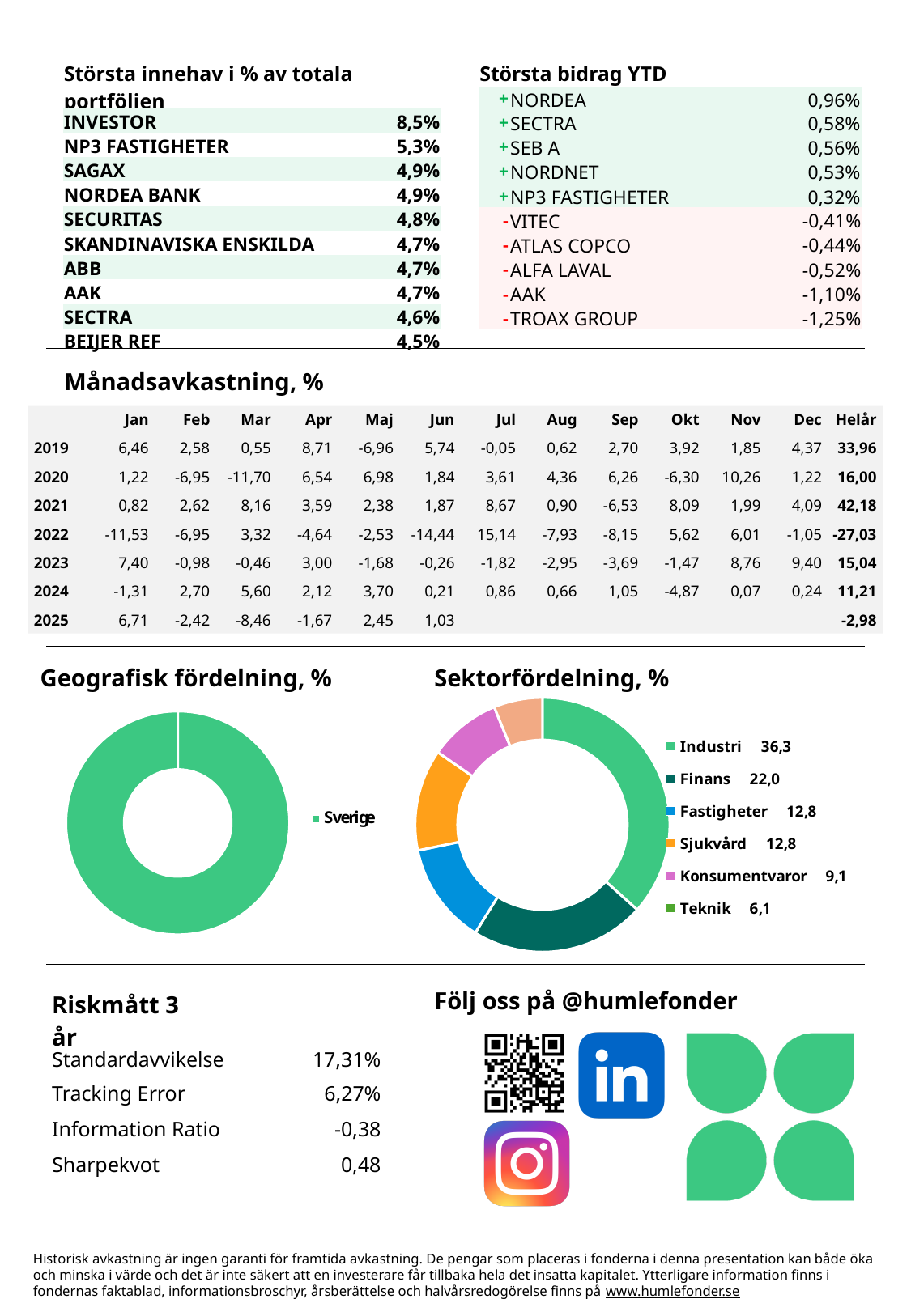
In the Sektorfördelning, % chart, which sector has the smallest share? Teknik In the Sektorfördelning, % chart, what is the value for Industri? 36,3 In the Sektorfördelning, % chart, which sector has the largest share? Industri In the Sektorfördelning, % chart, what colour is the Fastigheter slice? blue In the Sektorfördelning, % chart, what is the difference between Industri and Finans? 14,3 In the Sektorfördelning, % chart, what is the value for Finans? 22,0 What is the only legend entry in the Geografisk fördelning, % chart? Sverige What kind of chart is the Sektorfördelning, % chart? doughnut chart How many categories does the Geografisk fördelning, % chart show? 1 In the Sektorfördelning, % chart, what is the value for Konsumentvaror? 9,1 How many sectors are shown in the Sektorfördelning, % chart? 6 In the Sektorfördelning, % chart, which is larger, Konsumentvaror or Teknik? Konsumentvaror